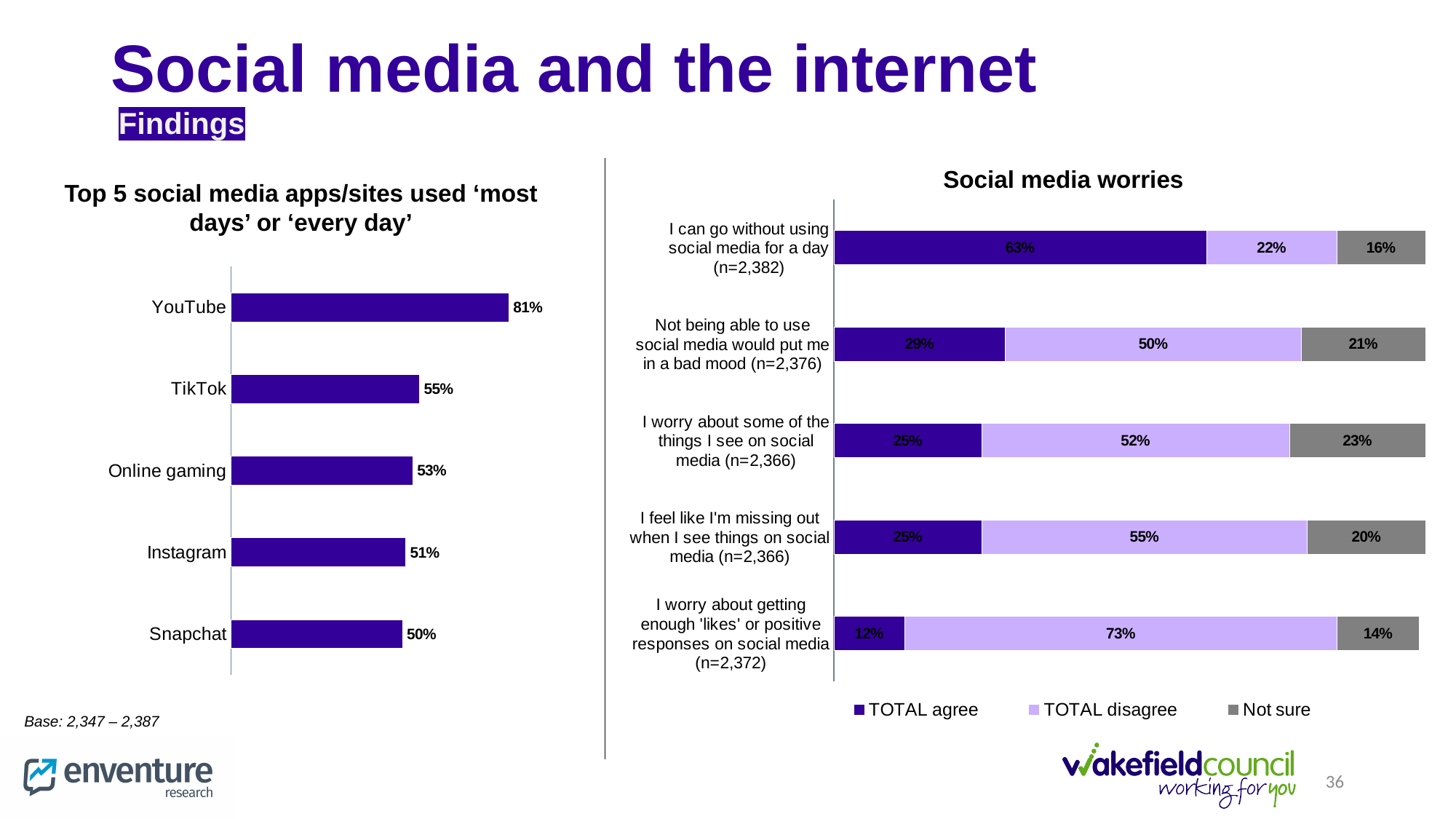
In the 'Top 5 social media apps/sites' chart, which is larger: Online gaming or Instagram? Online gaming In the 'Social media worries' chart, how many series does the legend list? 3 In the 'Social media worries' chart, what is the Not sure value for 'I worry about some of the things I see on social media'? 23% In the 'Top 5 social media apps/sites' chart, how many apps/sites are shown? 5 In the 'Social media worries' chart, what is the TOTAL disagree value for 'I worry about getting enough likes or positive responses on social media'? 73% In the 'Top 5 social media apps/sites' chart, what is the difference between YouTube and TikTok? 26 percentage points In the 'Top 5 social media apps/sites' chart, what is the value for YouTube? 81% In the 'Social media worries' chart, which statement has the highest TOTAL agree value? I can go without using social media for a day In the 'Top 5 social media apps/sites' chart, which app/site has the lowest value? Snapchat What kind of chart is the 'Social media worries' chart? Stacked bar chart In the 'Social media worries' chart, what is the TOTAL agree value for 'I can go without using social media for a day'? 63% In the 'Social media worries' chart, what is the total of the stacked bar for 'Not being able to use social media would put me in a bad mood'? 100%